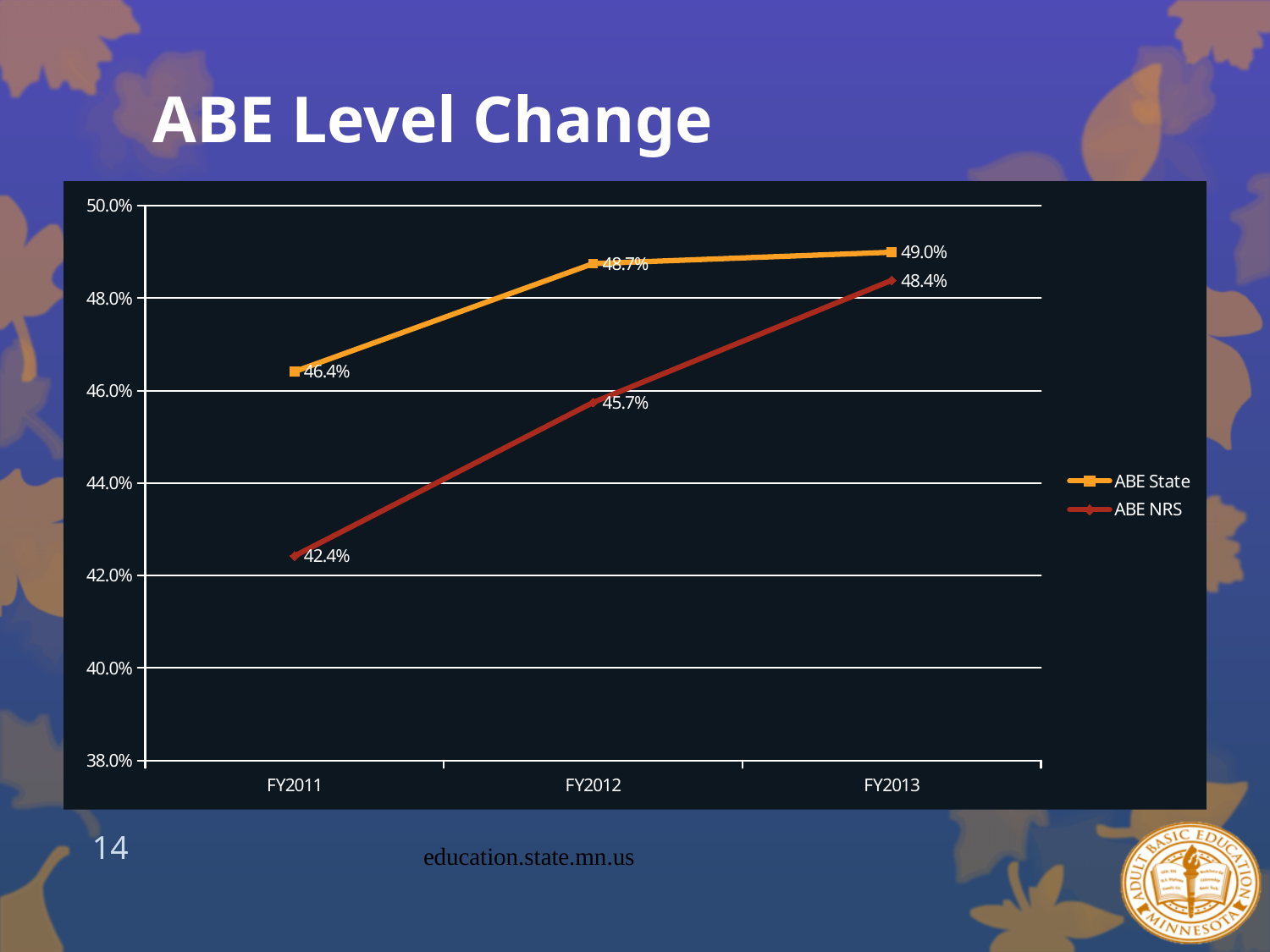
How many series does the legend list? 2 What kind of chart is shown on the slide? Line chart What is the ABE State value for FY2013? 49.0% In which fiscal year is the ABE State value highest? FY2013 What is the difference between the ABE State and ABE NRS values in FY2011? 4.0% Does the ABE NRS value rise or fall from FY2011 to FY2013? Rise What is the ABE NRS value for FY2011? 42.4% What is the ABE State value for FY2011? 46.4% How many fiscal years are shown on the x axis? 3 What is the ABE NRS value for FY2012? 45.7% Which series has the higher value in FY2012, ABE State or ABE NRS? ABE State In which fiscal year is the ABE NRS value lowest? FY2011